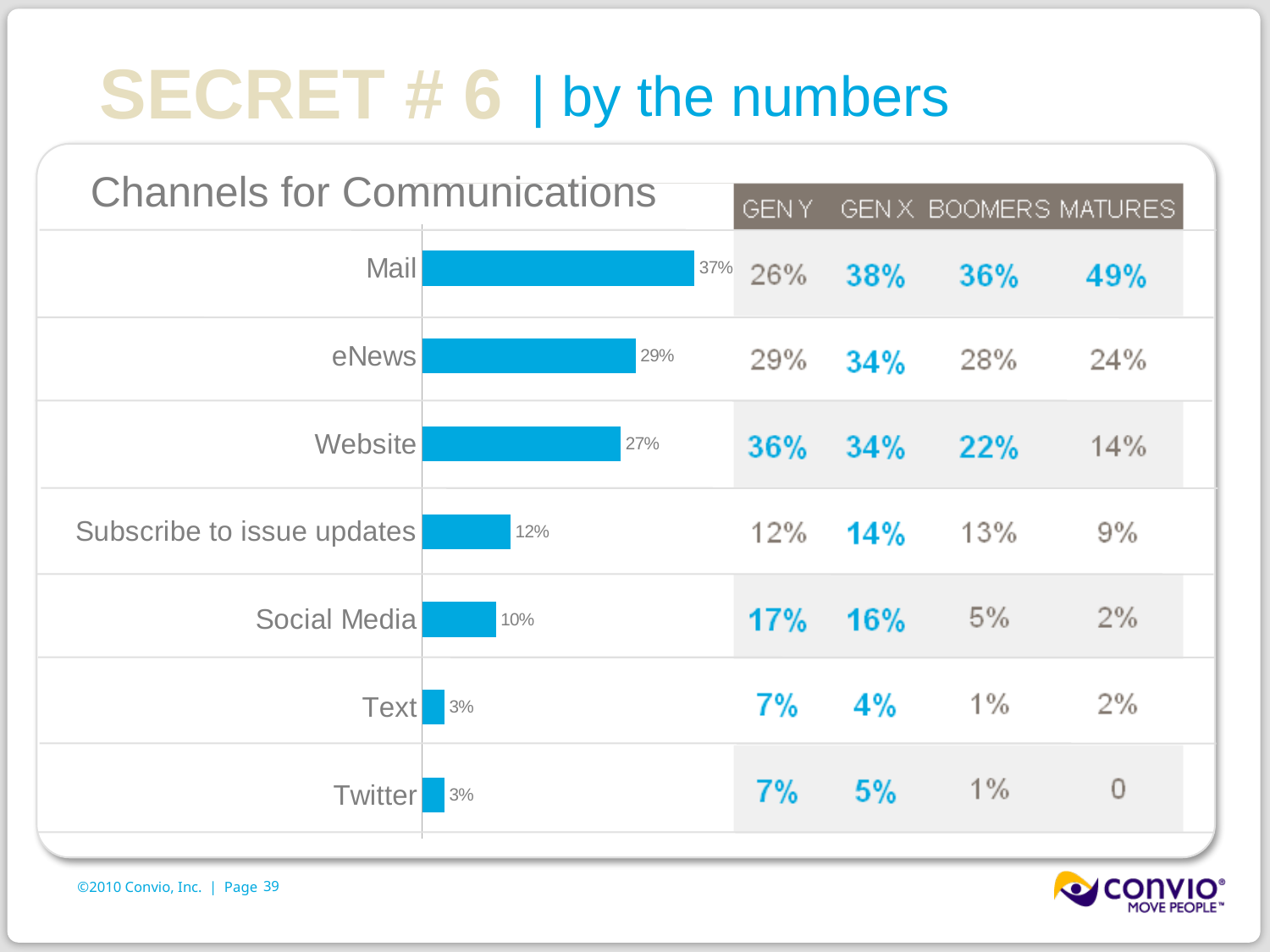
Which category has the highest value in the Channels for Communications chart? Mail What is the difference between the values for Mail and eNews in the Channels for Communications chart? 8% What is the value for Mail in the Channels for Communications chart? 37% What colour are the bars in the Channels for Communications chart? blue What is the title of the bar chart on the slide? Channels for Communications How many categories are shown in the Channels for Communications chart? 7 What is the difference between the values for Subscribe to issue updates and Social Media in the Channels for Communications chart? 2% Which is larger in the Channels for Communications chart, the value for Website or the value for Subscribe to issue updates? Website What is the value for Social Media in the Channels for Communications chart? 10% What is the value for Website in the Channels for Communications chart? 27% Which is larger in the Channels for Communications chart, the value for eNews or the value for Website? eNews What kind of chart is the Channels for Communications chart? bar chart